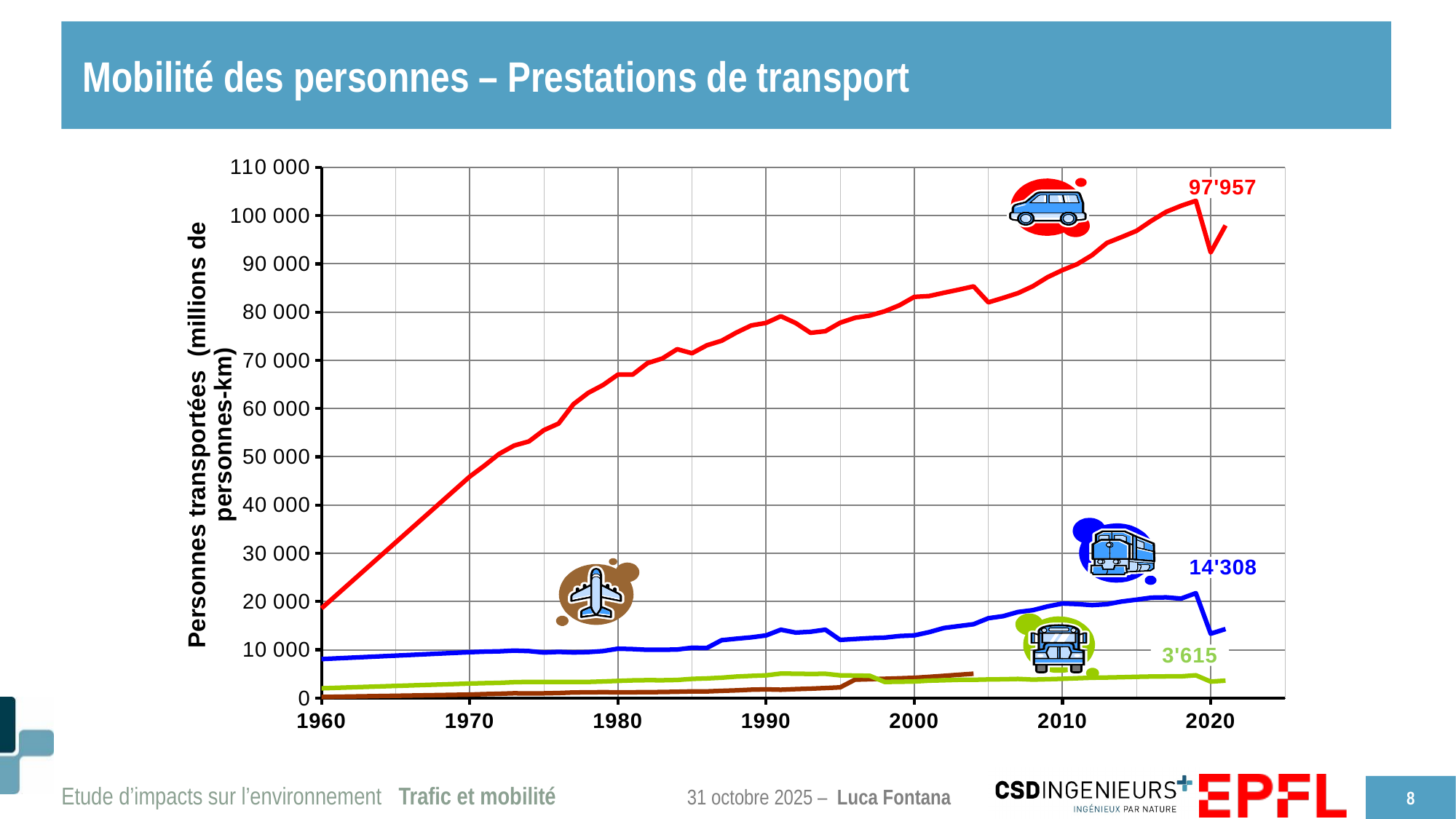
What is the difference between the final labelled values of the red line (97'957) and the blue line (14'308)? 83'649 Which line has the highest final labelled value? the red line (car), 97'957 What kind of chart is shown on the slide? line chart How many lines are plotted on the chart? 4 What is the final labelled value of the blue line (train)? 14'308 What is the final labelled value of the red line (car)? 97'957 Is the value of the red line in 1980 greater or less than 60 000? greater Does the red line generally rise or fall between 1960 and 2019? rise Which of the three labelled final values is the lowest? 3'615 (green line, bus) What is the final labelled value of the green line (bus)? 3'615 What is the difference between the final labelled values of the blue line (14'308) and the green line (3'615)? 10'693 Is the value of the blue line in 1960 greater or less than 10 000? less